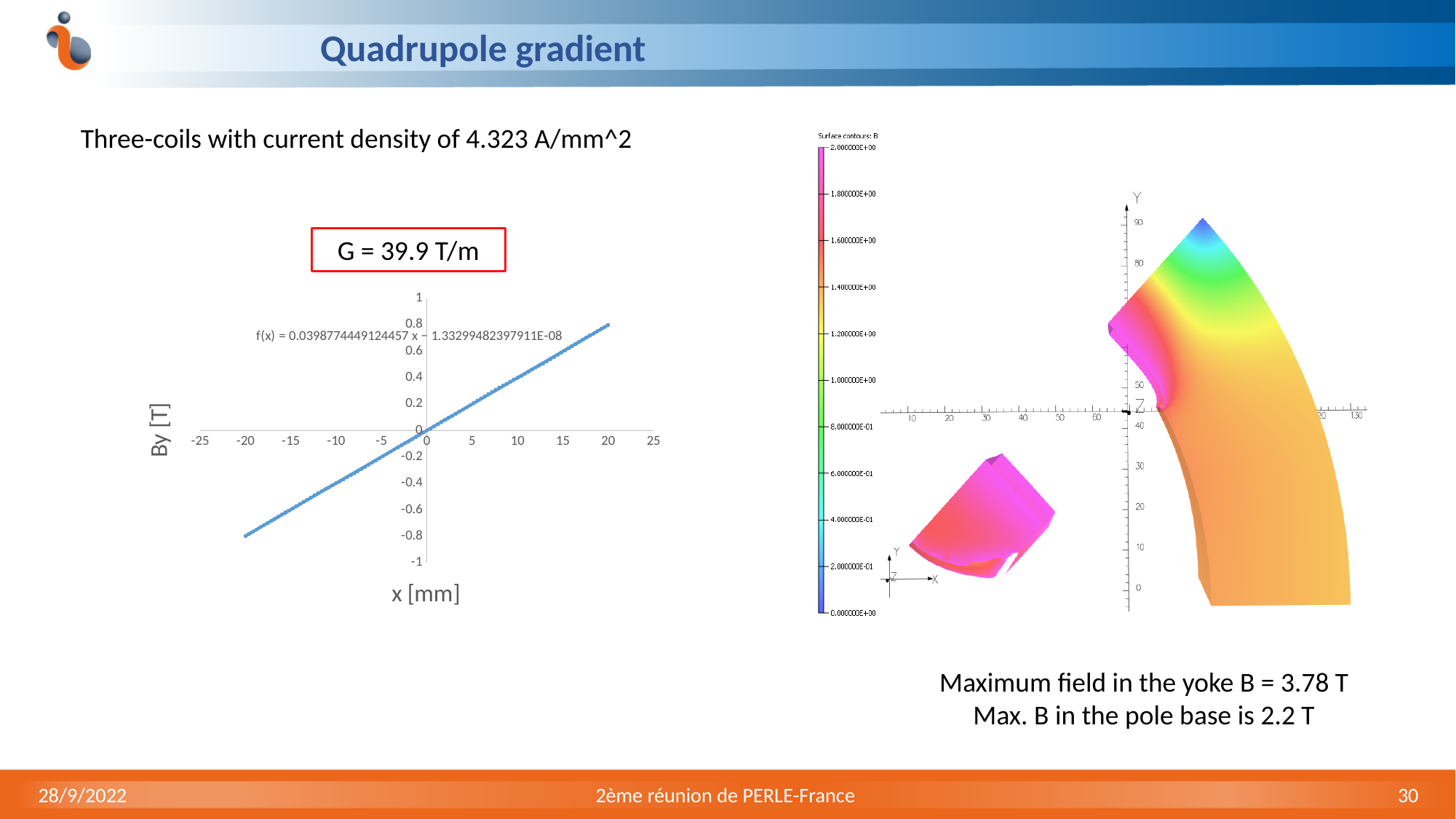
In the By versus x chart, is the value of By at x = -10 greater or less than -0.2? less In the By versus x chart, is the value of By at x = 20 greater or less than 1? less In the By versus x chart, is the value of By at x = 20 greater or less than 0.6? greater In the By versus x chart, do the values rise or fall as x increases from -20 to 20? Rise What kind of chart is shown on the left of the slide? Scatter (line) chart In the By versus x chart, is By larger at x = 15 or at x = 5? x = 15 What is the maximum value shown on the vertical axis of the By versus x chart? 1 What is the label of the horizontal axis of the By versus x chart? x [mm] What is the label of the vertical axis of the By versus x chart? By [T]